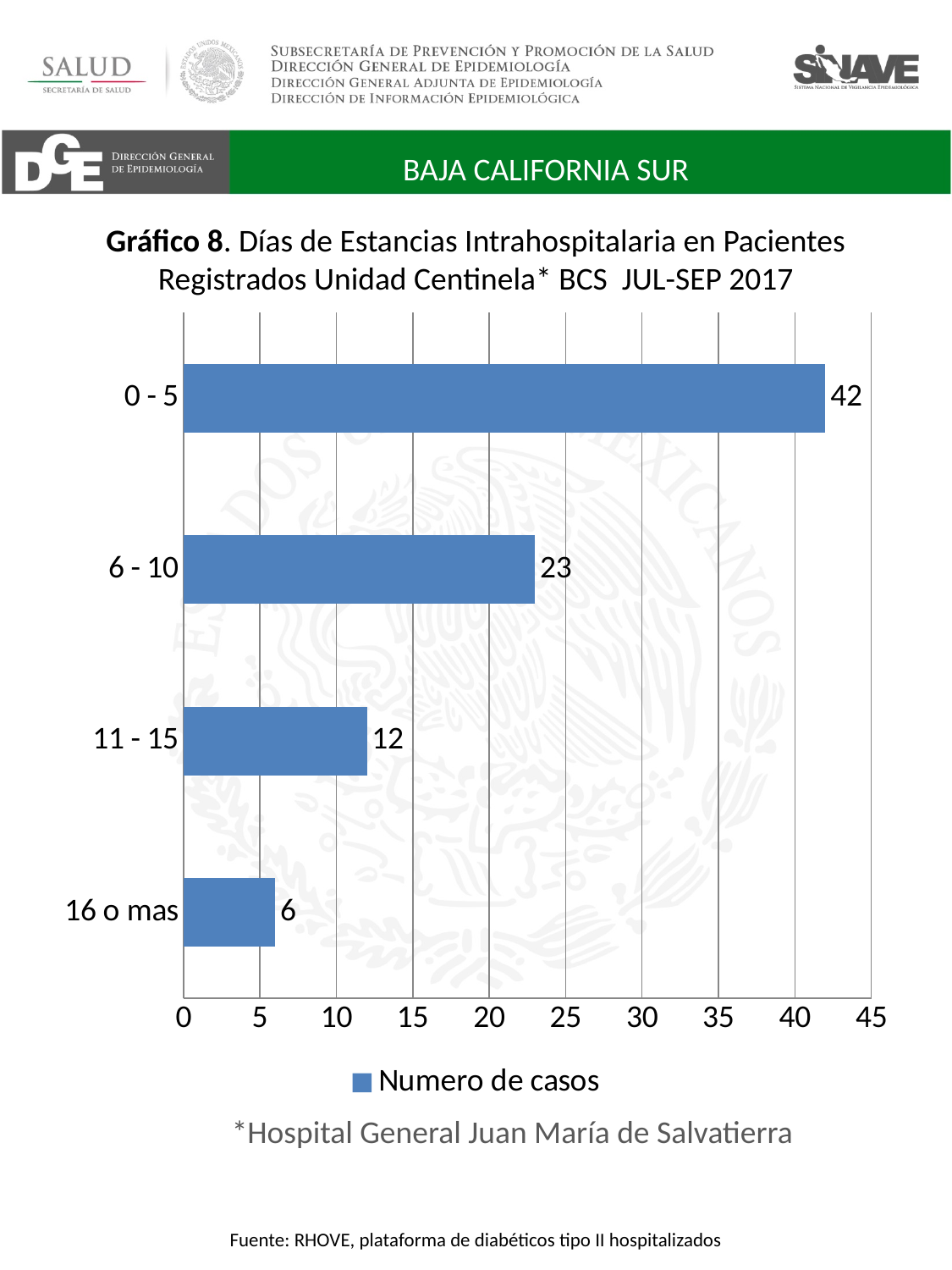
How many categories are shown in the chart? 4 Which has more cases, the 11 - 15 category or the 16 o mas category? 11 - 15 How many series does the legend list? 1 What is the difference in number of cases between the 0 - 5 and 6 - 10 categories? 19 Which category has the lowest number of cases? 16 o mas What kind of chart is shown on the slide? Bar chart What is the legend entry for the series in the chart? Numero de casos What is the number of cases for the 6 - 10 days category? 23 What is the number of cases for the 11 - 15 days category? 12 What is the number of cases for the 0 - 5 days category? 42 Which category has the highest number of cases? 0 - 5 What is the number of cases for the 16 o mas category? 6